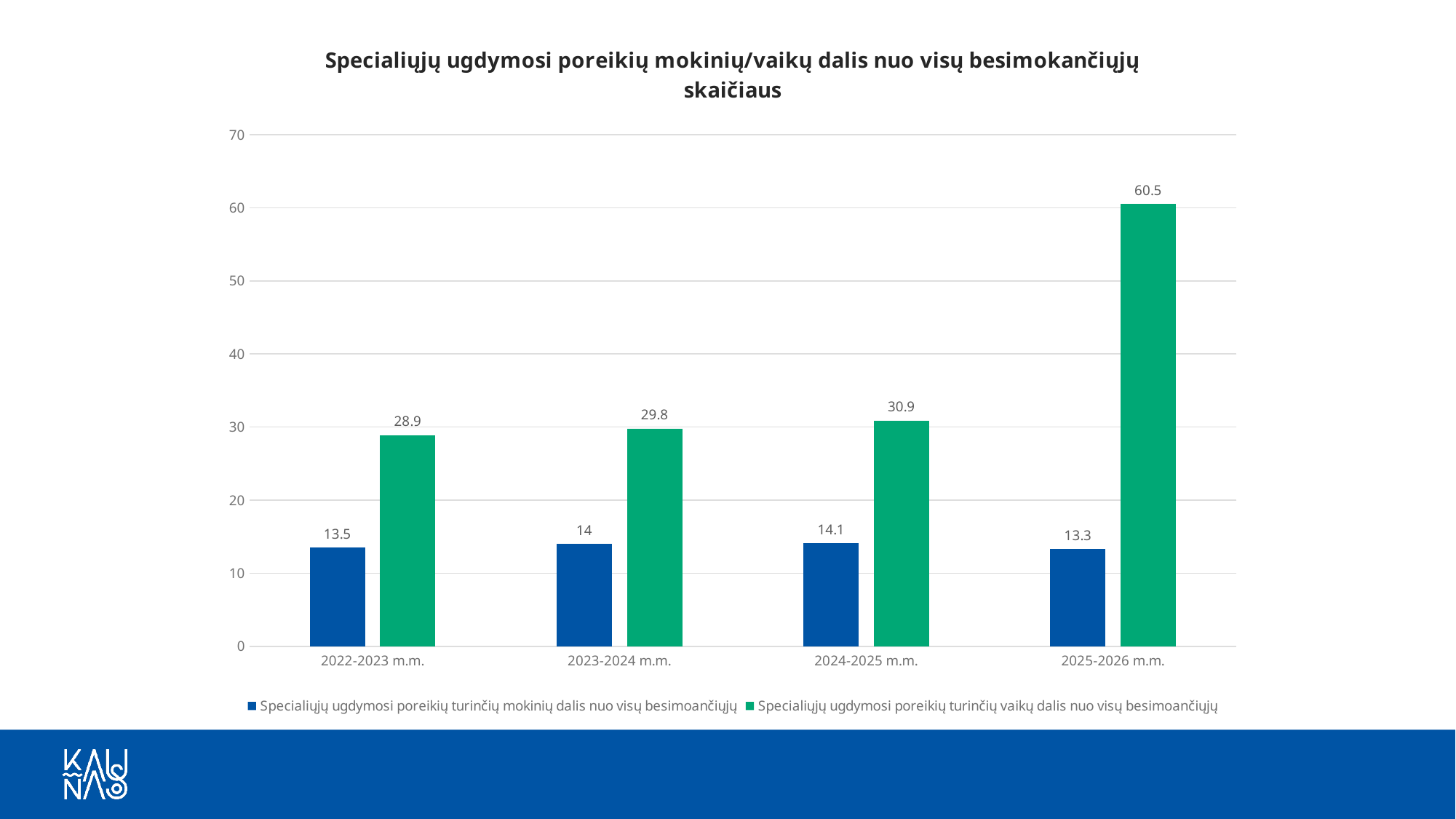
What is the difference between the 'vaikų' (green) values for 2024-2025 m.m. and 2023-2024 m.m.? 1.1 Which is larger in 2024-2025 m.m.: the 'mokinių' (blue) value or the 'vaikų' (green) value? vaikų (green) What is the value for the 'mokinių' (blue) series in 2023-2024 m.m.? 14 What is the value for the 'vaikų' (green) series in 2025-2026 m.m.? 60.5 What is the difference between the 'vaikų' (green) value and the 'mokinių' (blue) value in 2025-2026 m.m.? 47.2 In which school year is the 'mokinių' (blue) series lowest? 2025-2026 m.m. What kind of chart is shown on the slide? bar chart In which school year is the 'vaikų' (green) series highest? 2025-2026 m.m. How many series does the legend list? 2 Is the 'vaikų' (green) value for 2025-2026 m.m. greater or less than 50? greater How many school years are shown on the x axis? 4 What is the value for the 'vaikų' (green) series in 2022-2023 m.m.? 28.9